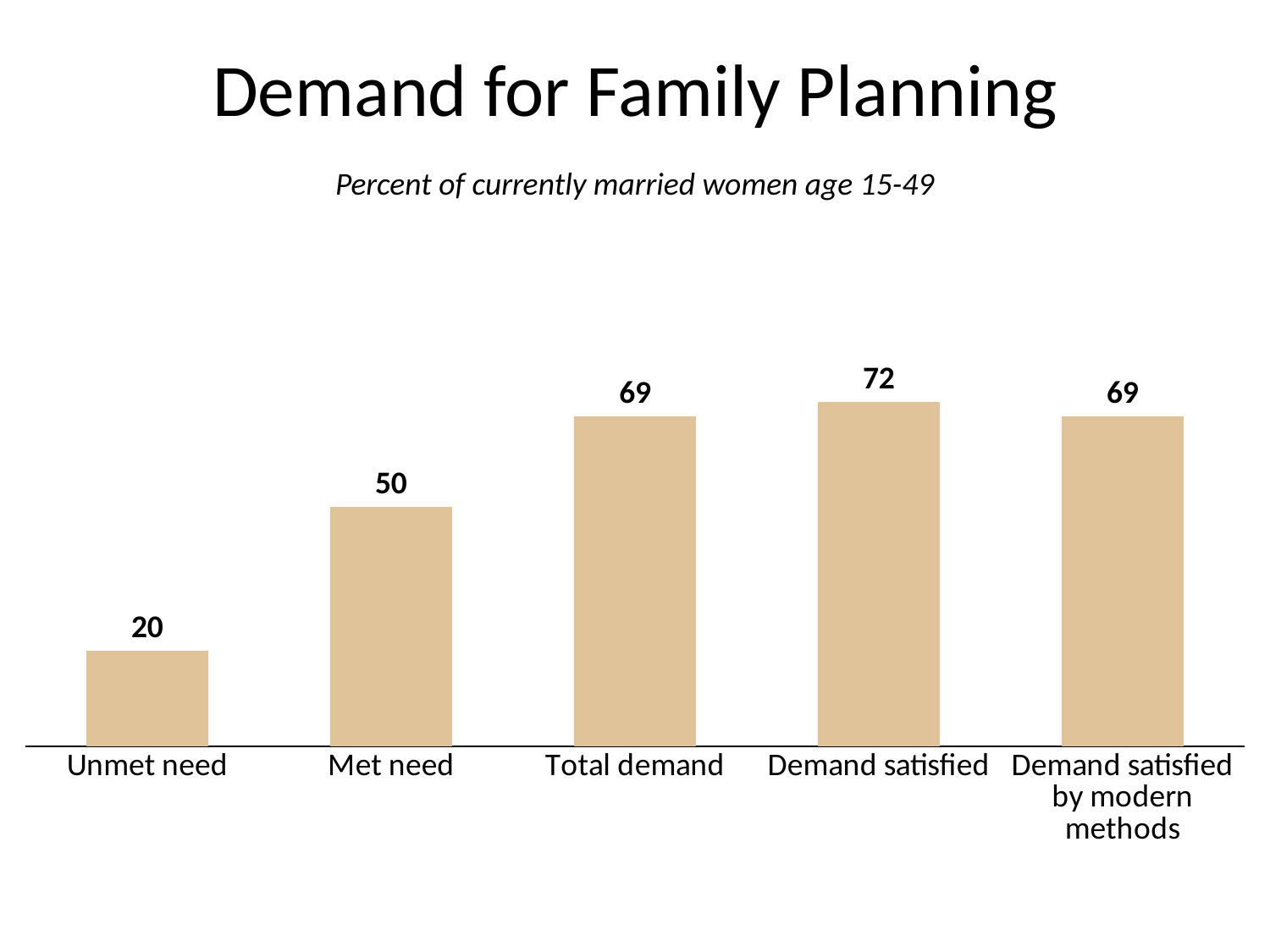
How many categories are shown in the chart? 5 What is the value for Demand satisfied by modern methods? 69 What is the difference between the values for Met need and Unmet need? 30 What is the value for Unmet need? 20 What is the value for Met need? 50 Which category has the lowest value? Unmet need What is the value for Demand satisfied? 72 Which category has the highest value? Demand satisfied Which is larger, the value for Met need or the value for Total demand? Total demand What is the value for Total demand? 69 What type of chart is shown on the slide? Bar chart What is the difference between the values for Demand satisfied and Total demand? 3